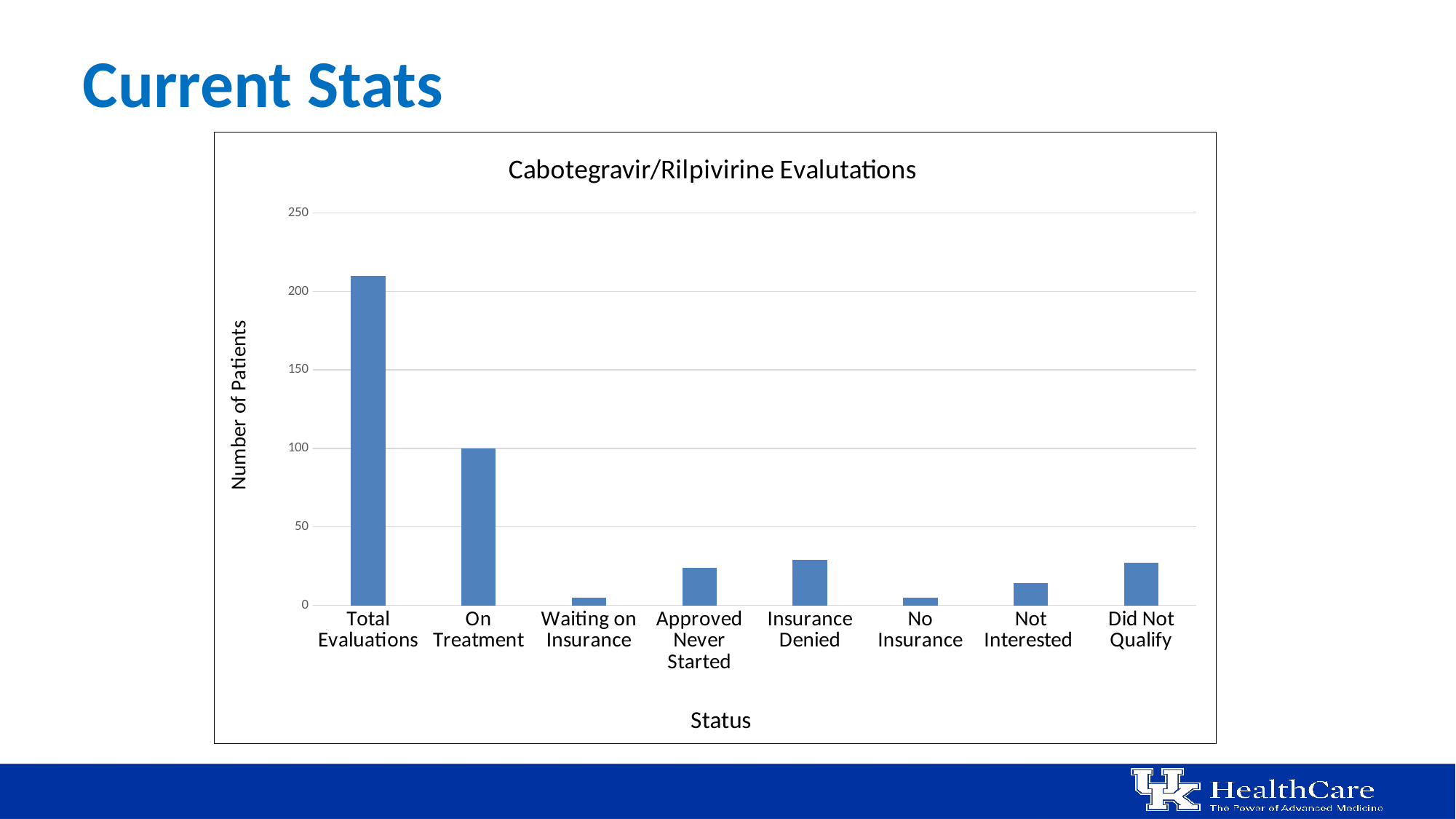
What is the title of the chart? Cabotegravir/Rilpivirine Evalutations What is the number of patients for On Treatment? 100 Which has more patients, Total Evaluations or On Treatment? Total Evaluations Which has more patients, Insurance Denied or Not Interested? Insurance Denied Is the value for Approved Never Started greater or less than 50? less Is the value for Total Evaluations greater or less than 200? greater What type of chart is shown on the slide? Bar chart Is the value for Insurance Denied greater or less than 50? less Which status category has the highest number of patients? Total Evaluations How many status categories are shown on the x axis? 8 What is the label of the vertical axis? Number of Patients Which has more patients, Did Not Qualify or Waiting on Insurance? Did Not Qualify